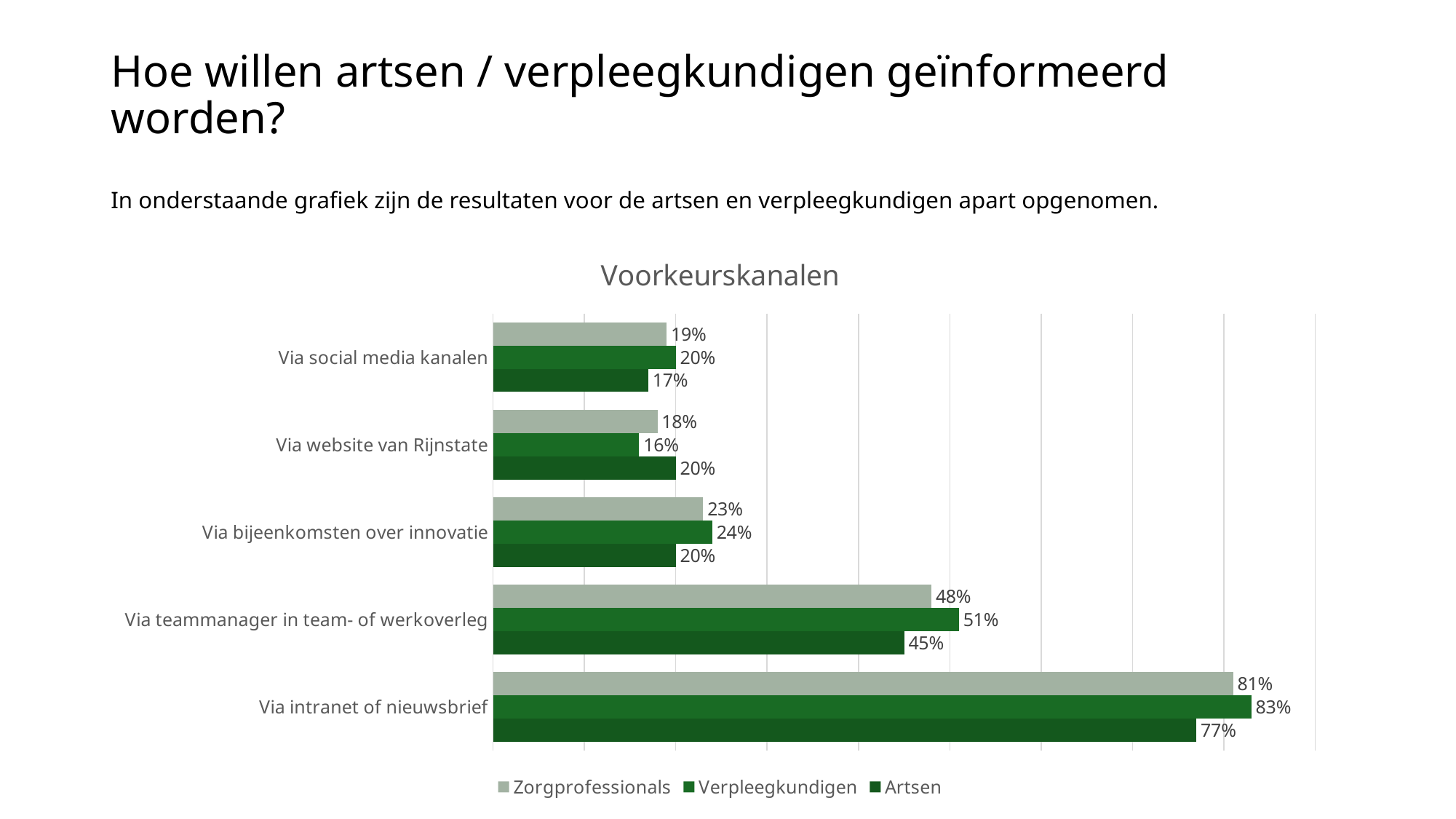
What is the value for Artsen for 'Via intranet of nieuwsbrief'? 77% Which category has the highest value for Verpleegkundigen? Via intranet of nieuwsbrief What kind of chart is shown? Bar chart What is the value for Verpleegkundigen for 'Via teammanager in team- of werkoverleg'? 51% Which category has the lowest value for Artsen? Via social media kanalen Which is larger for 'Via website van Rijnstate': the Verpleegkundigen value or the Artsen value? Artsen How many series does the legend list? 3 What is the value for Zorgprofessionals for 'Via bijeenkomsten over innovatie'? 23% Which series is shown in the lightest (grey-green) colour? Zorgprofessionals How many categories are shown on the chart? 5 What is the title of the chart? Voorkeurskanalen What is the difference between the Verpleegkundigen and Artsen values for 'Via intranet of nieuwsbrief'? 6%